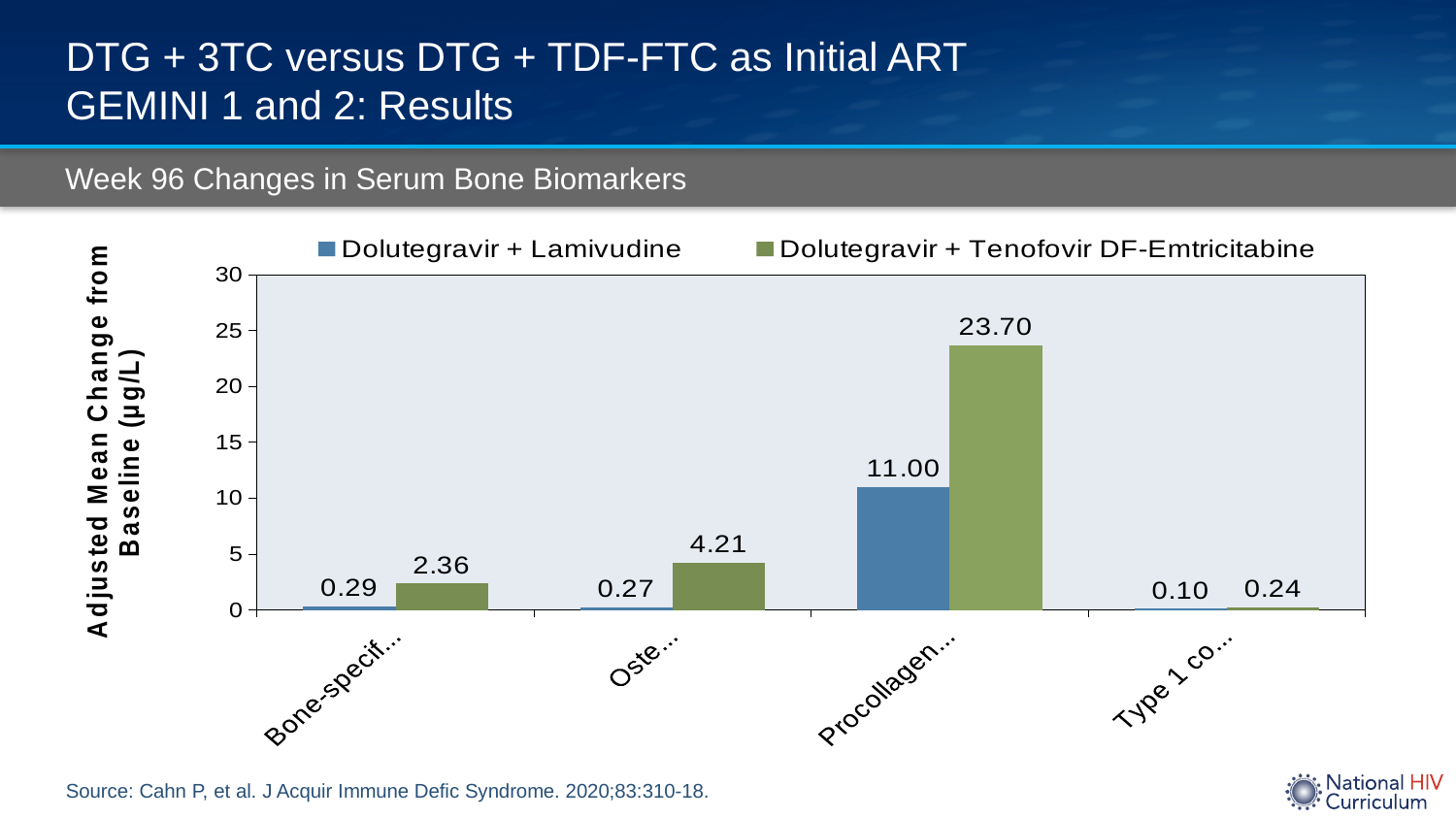
What is the value for Dolutegravir + Tenofovir DF-Emtricitabine in the category labeled "Oste..."? 4.21 What is the value for Dolutegravir + Lamivudine in the category labeled "Bone-specif..."? 0.29 In the category labeled "Oste...", what is the difference between the Dolutegravir + Tenofovir DF-Emtricitabine value and the Dolutegravir + Lamivudine value? 3.94 What is the value for Dolutegravir + Tenofovir DF-Emtricitabine in the category labeled "Procollagen..."? 23.70 In the category labeled "Procollagen...", what is the difference between the Dolutegravir + Tenofovir DF-Emtricitabine value and the Dolutegravir + Lamivudine value? 12.70 Which category has the highest value for Dolutegravir + Tenofovir DF-Emtricitabine? Procollagen... What kind of chart is shown on the slide? Bar chart What is the value for Dolutegravir + Lamivudine in the category labeled "Procollagen..."? 11.00 How many series does the chart legend list? 2 How many categories are shown on the x axis of the chart? 4 Which category has the lowest value for Dolutegravir + Lamivudine? Type 1 co... For Dolutegravir + Tenofovir DF-Emtricitabine, which category has the larger value: "Bone-specif..." or "Oste..."? Oste...